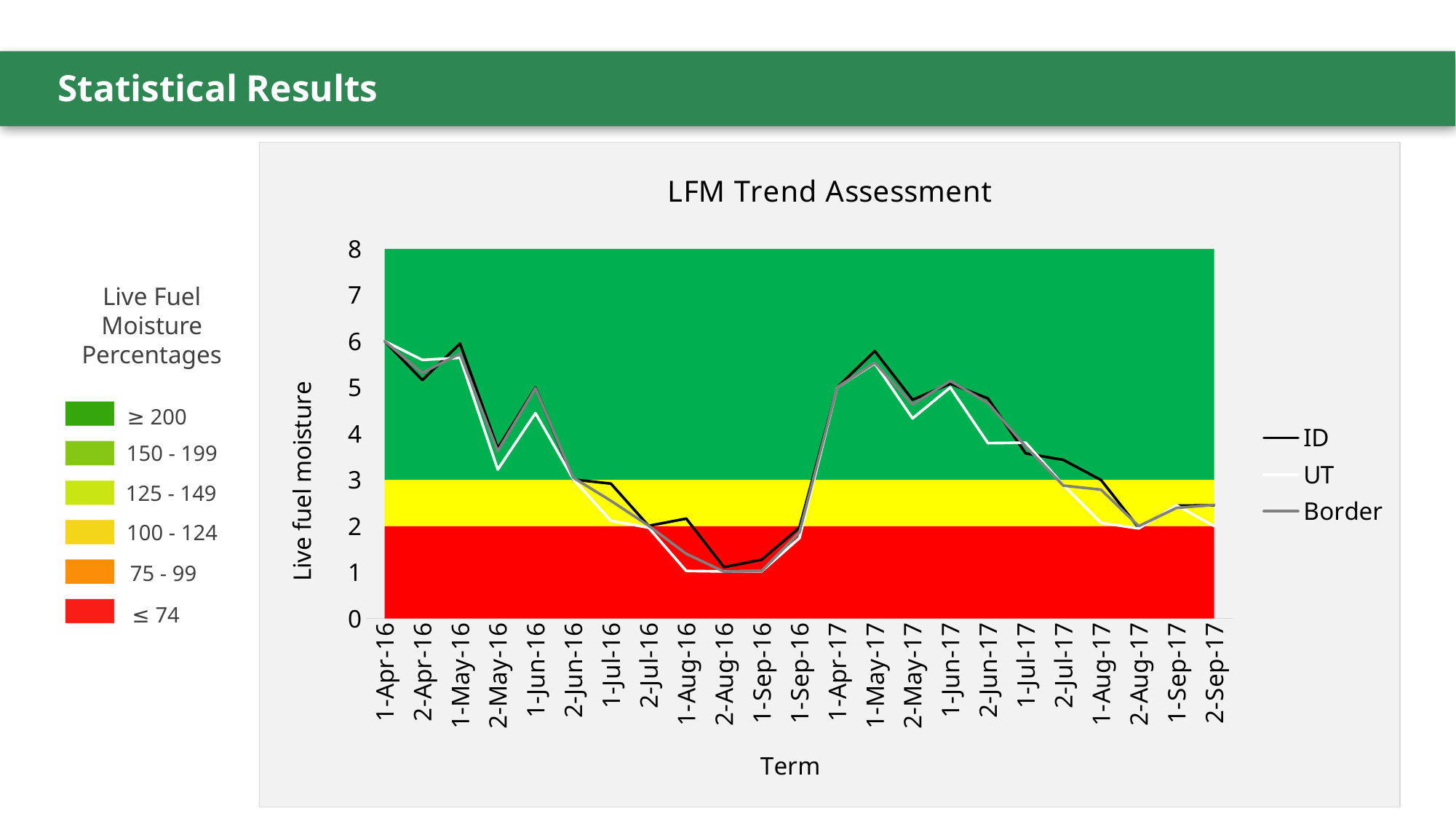
What kind of chart is the LFM Trend Assessment? line chart Is the ID value at 1-May-17 greater or less than 5? greater Is the UT value at 1-Aug-16 greater or less than 2? less At 2-Jun-17, which series has the higher value, ID or UT? ID Does the ID series rise or fall from 1-Apr-16 to 2-Aug-16? fall Is the Border value at 2-Jun-16 greater or less than 2? greater How many terms are shown along the x axis of the LFM Trend Assessment chart? 23 At 1-Jun-16, which series has the higher value, ID or UT? ID Which series are listed in the legend of the LFM Trend Assessment chart? ID, UT, Border How many series does the legend of the LFM Trend Assessment chart list? 3 What is the label of the y axis on the LFM Trend Assessment chart? Live fuel moisture